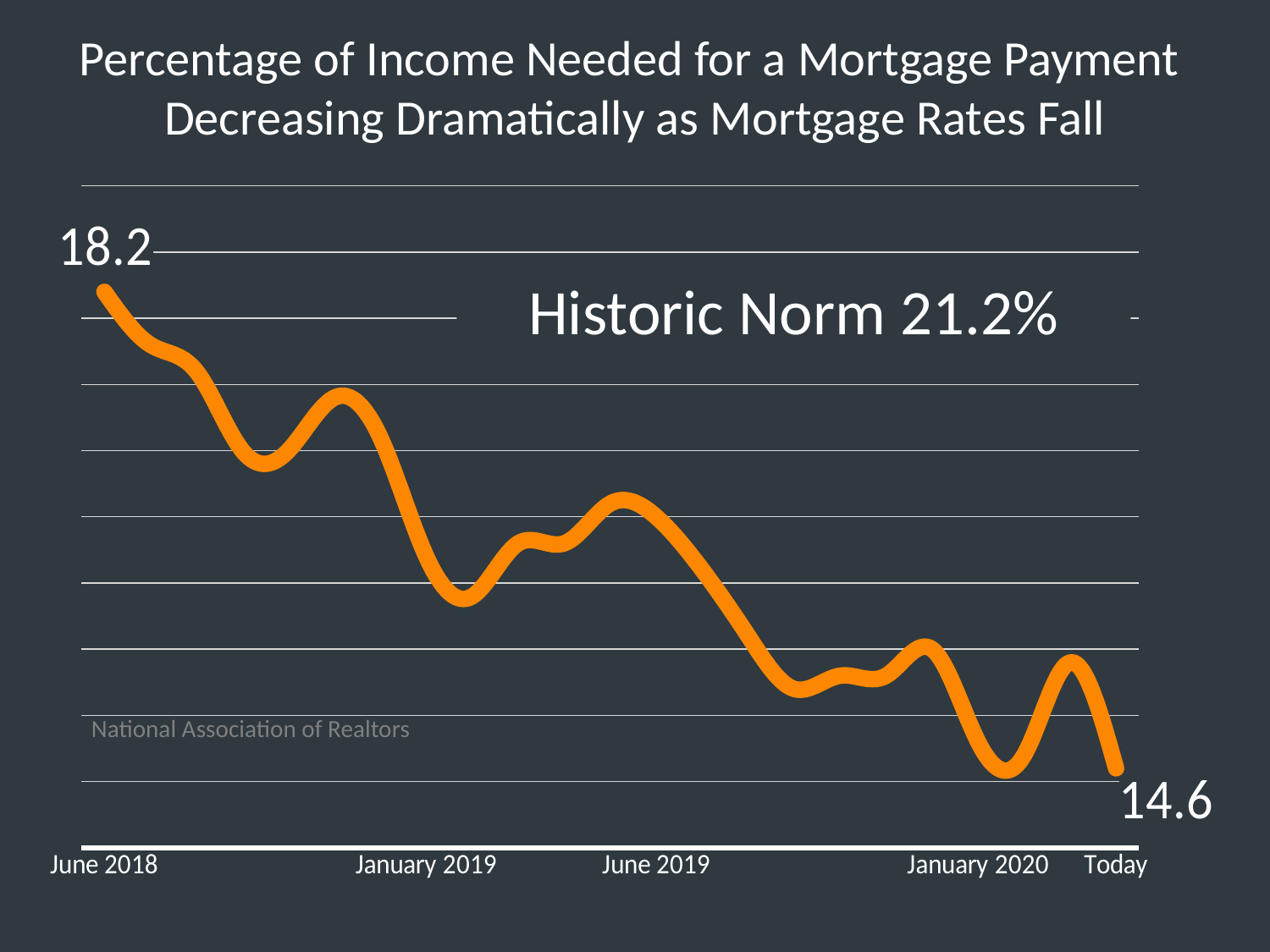
Do the values generally rise or fall from June 2018 to Today? fall What is the difference between the June 2018 value and the Today value? 3.6 What kind of chart is shown on the slide? line chart What is the value shown for Today? 14.6 Which is larger, the value for June 2018 or the value for Today? June 2018 What source is credited on the chart? National Association of Realtors How many labels are shown along the x axis? 5 How many data series are plotted on the chart? 1 What is the value shown for June 2018? 18.2 At which labelled point on the x axis is the line at its highest? June 2018 What historic norm percentage is stated on the chart? 21.2%